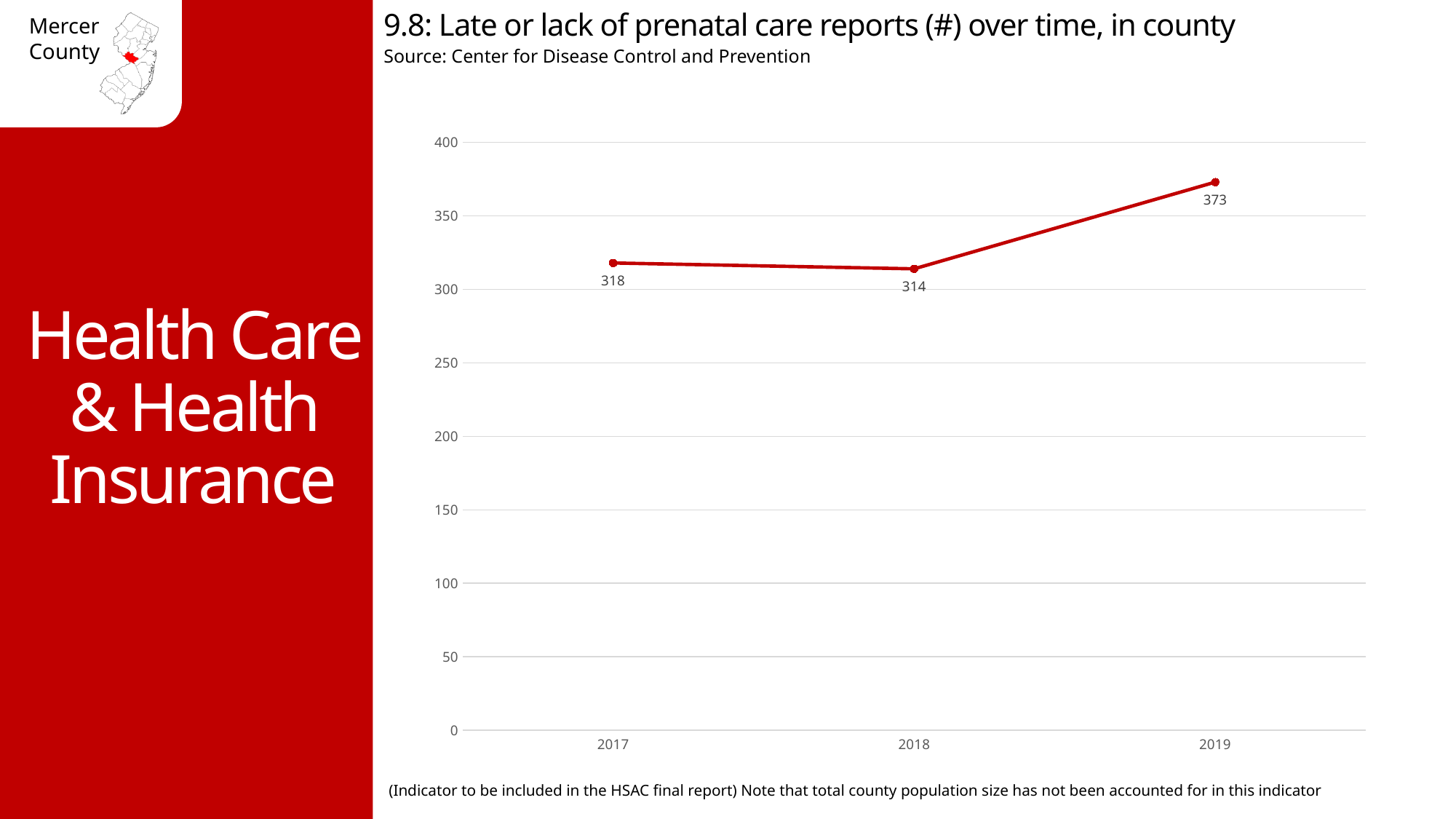
What is the difference between the 2019 and 2018 values? 59 Which year has the lowest number of late or lack of prenatal care reports? 2018 What kind of chart is shown on the slide? line chart What is the number of late or lack of prenatal care reports in 2018? 314 Is the value for 2019 greater or less than 350? greater What is the source of the data shown in the chart? Center for Disease Control and Prevention Which year has a larger value, 2017 or 2019? 2019 What is the number of late or lack of prenatal care reports in 2019? 373 What is the number of late or lack of prenatal care reports in 2017? 318 How many years are plotted on the chart? 3 What is the difference between the 2017 and 2018 values? 4 Which year has the highest number of late or lack of prenatal care reports? 2019